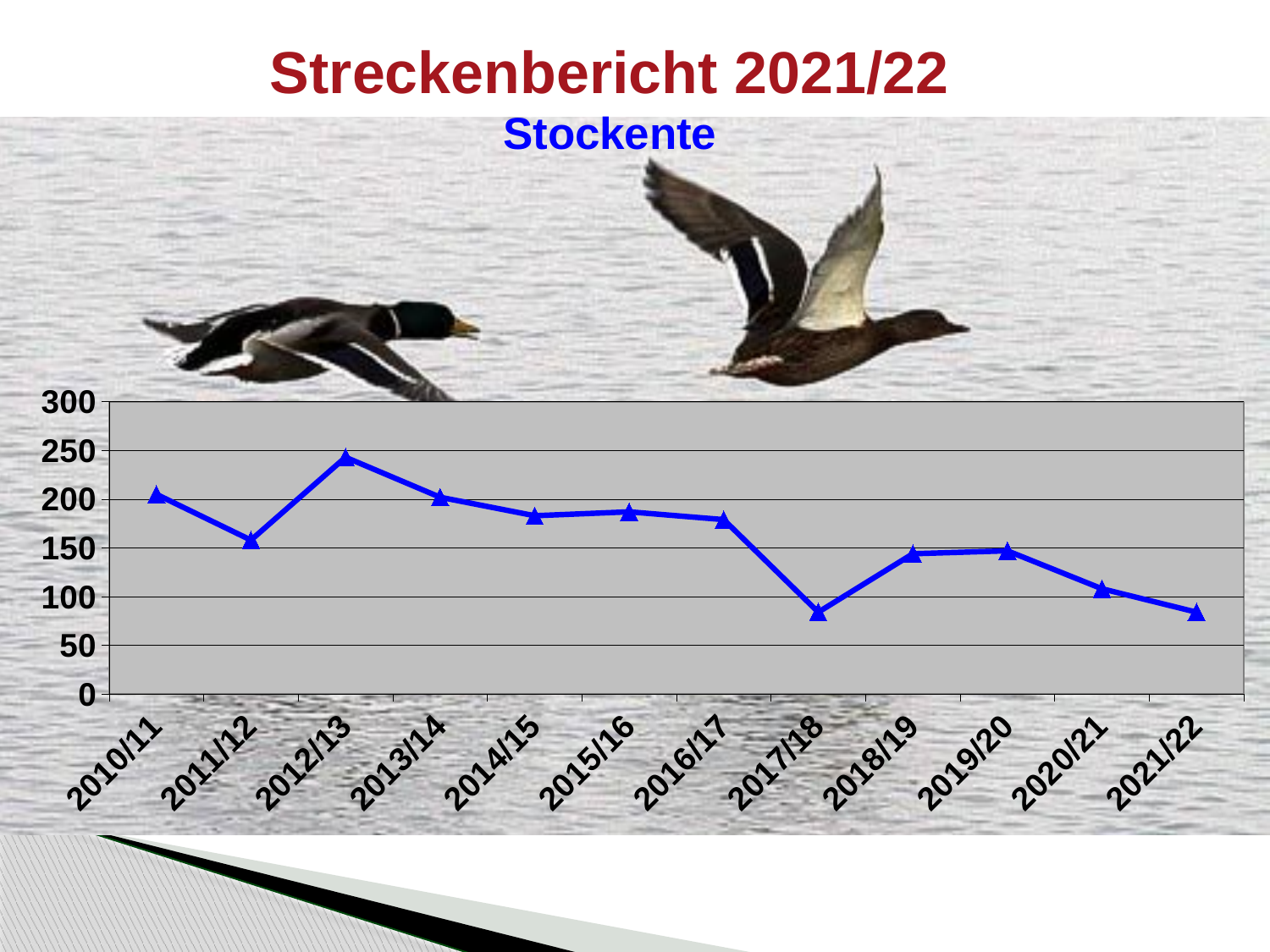
What is the title of the chart? Stockente Is the value for 2014/15 greater or less than 150? greater Is the value for 2017/18 greater or less than 100? less Which season has the highest value? 2012/13 Is the value for 2021/22 greater or less than 100? less Which is larger, the value for 2012/13 or the value for 2011/12? 2012/13 What kind of chart is shown on the slide? line chart What is the highest value shown on the y axis? 300 How many hunting seasons are plotted on the x axis? 12 Does the value rise or fall from 2017/18 to 2018/19? rise